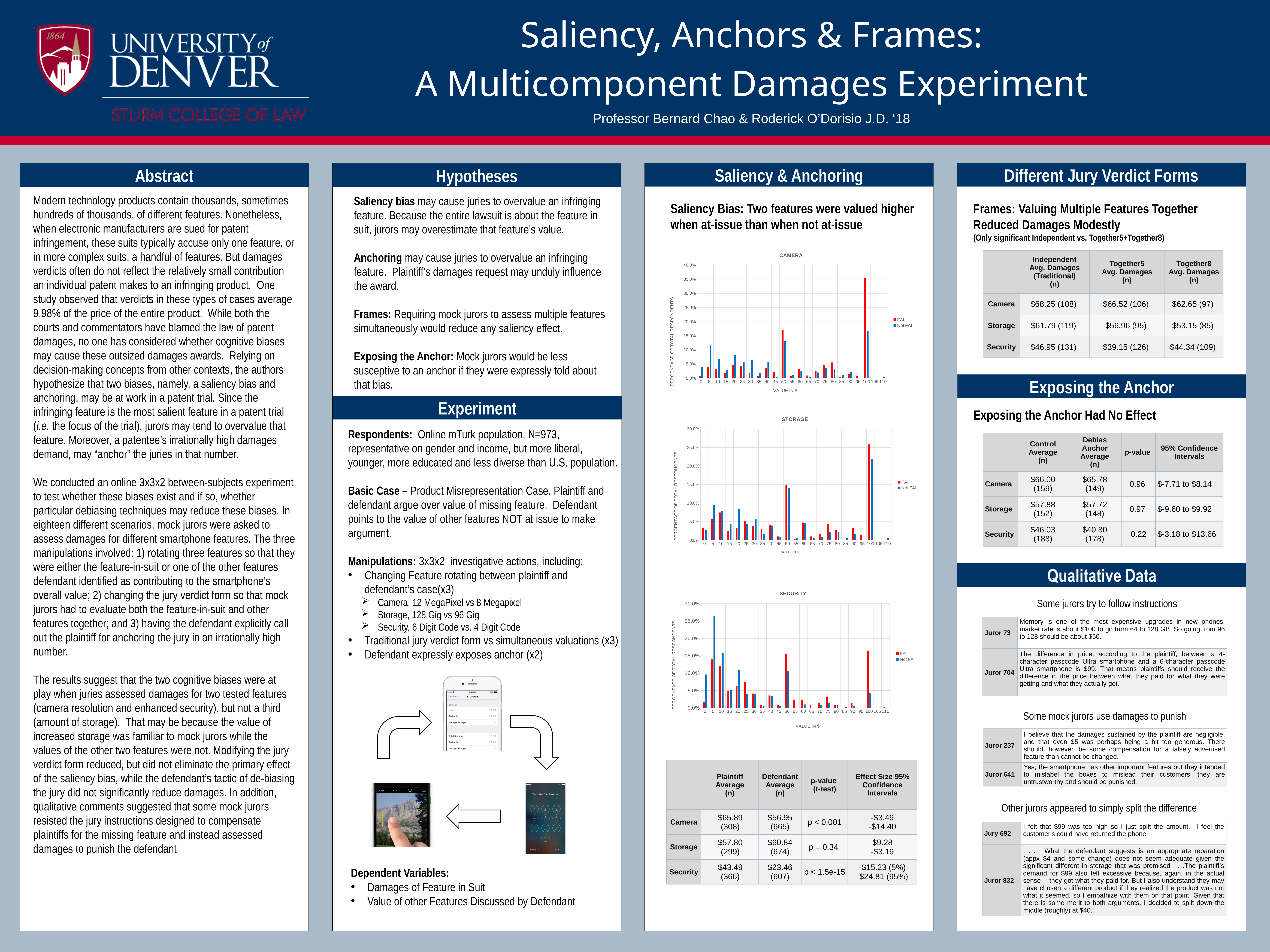
In the SECURITY chart, is the Not FAI value at $5 greater or less than 20.0%? greater In the STORAGE chart, is the Not FAI value at $100 greater or less than 20.0%? greater How many series does the legend of the STORAGE chart list? 2 What kind of chart is the CAMERA chart? bar chart What are the two series named in the legend of the SECURITY chart? FAI and Not FAI In the CAMERA chart, at which value in $ is the FAI bar highest? 100 In the CAMERA chart, at $100, which series has the larger value, FAI or Not FAI? FAI In the SECURITY chart, at $100, which series has the larger value, FAI or Not FAI? FAI In the CAMERA chart, is the FAI value at $100 greater or less than 30.0%? greater In the SECURITY chart, at which value in $ is the Not FAI bar highest? 5 What is the x-axis label on the CAMERA chart? VALUE IN $